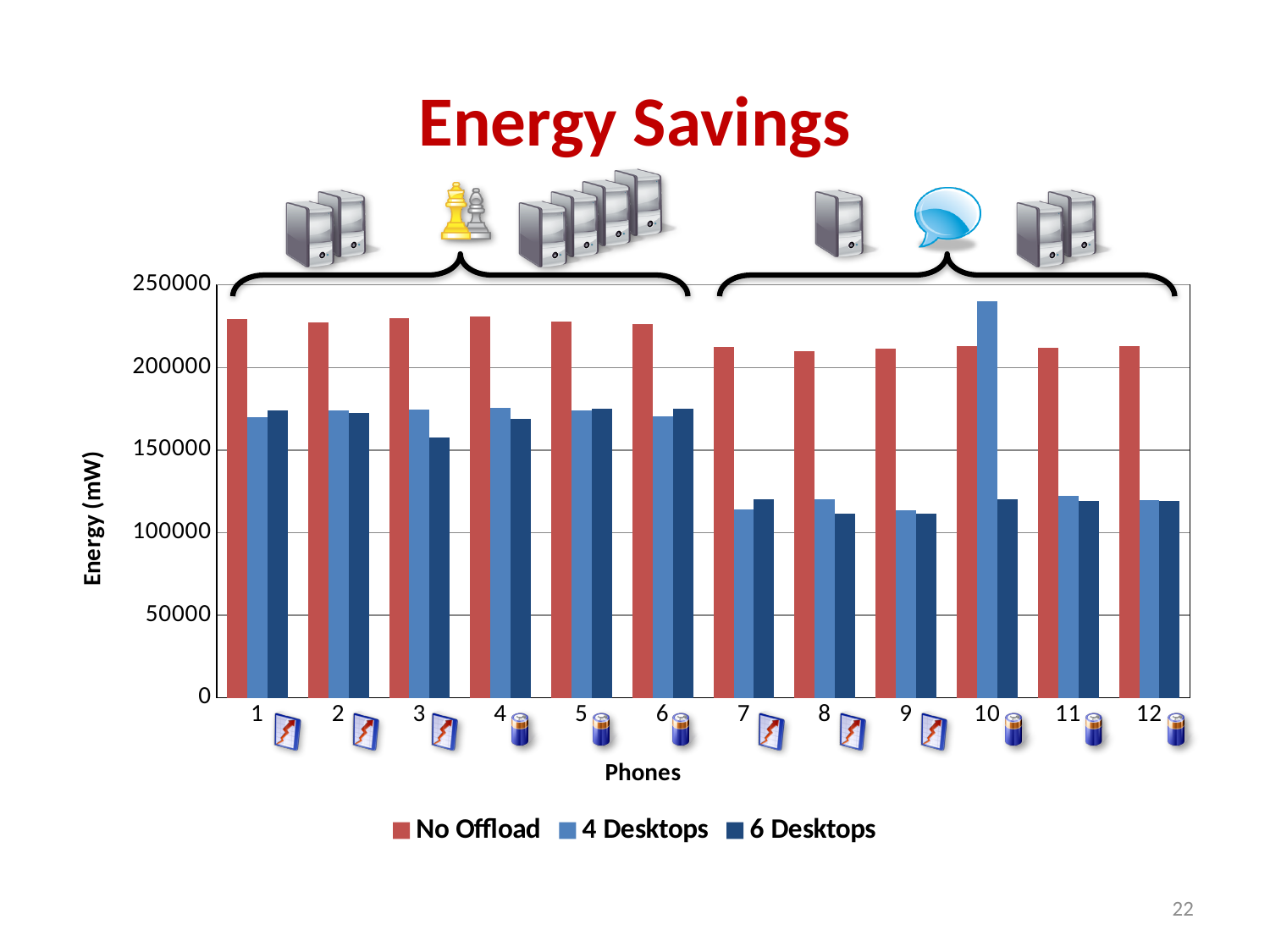
What is the title of the chart? Energy Savings Is the 6 Desktops value for phone 12 greater or less than 150000? less How many phones are shown on the x axis? 12 What kind of chart is shown on the slide? bar chart What is the label of the vertical axis? Energy (mW) For phone 10, which is larger: the No Offload value or the 4 Desktops value? 4 Desktops Is the 4 Desktops value for phone 7 greater or less than 150000? less For the 6 Desktops series, which is larger: the value for phone 3 or the value for phone 4? phone 4 Is the 4 Desktops value for phone 10 greater or less than 200000? greater Which series has the highest bar in the chart, and for which phone? 4 Desktops, phone 10 How many series does the legend list? 3